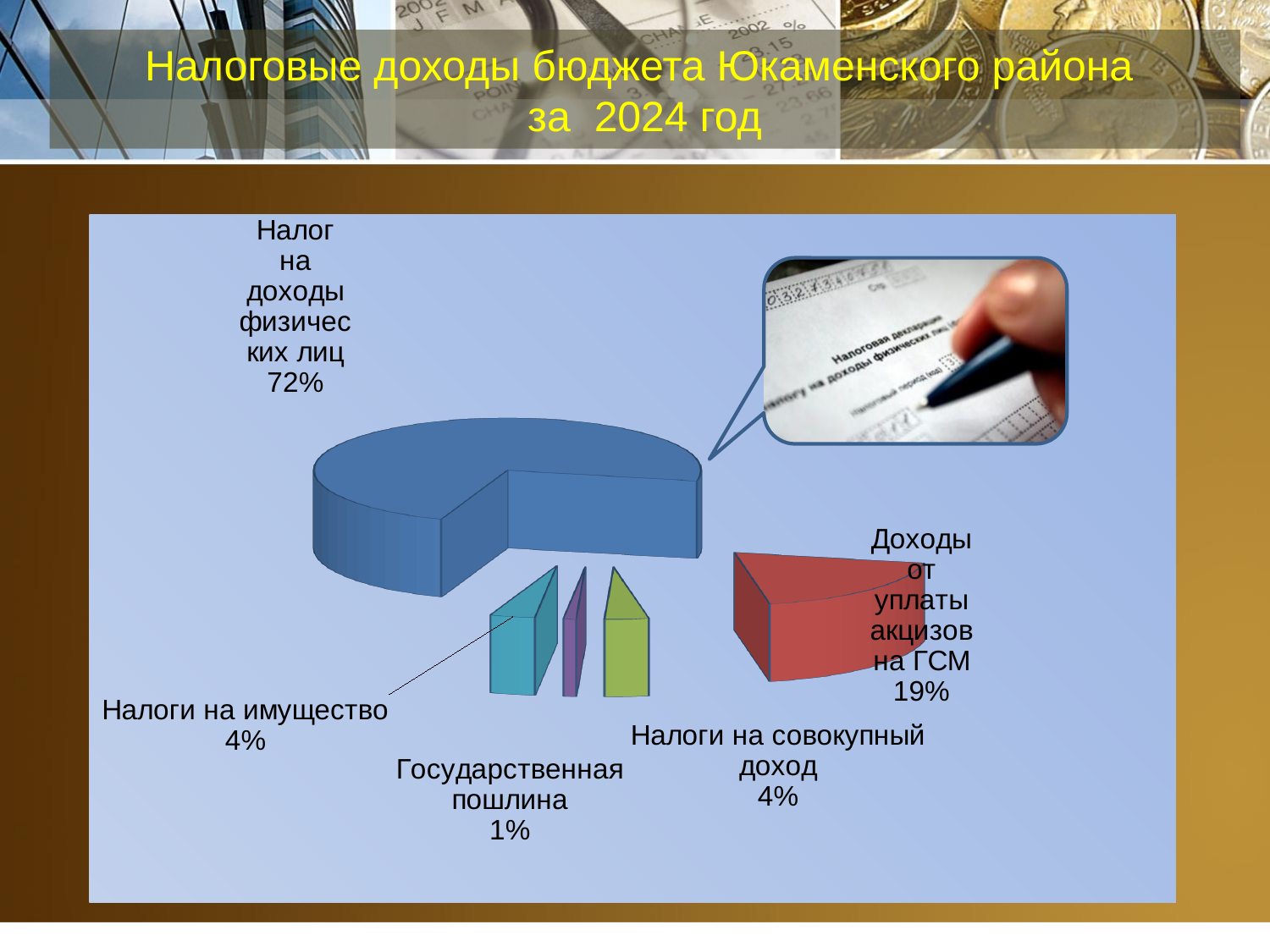
Which category has the largest share of the pie? Налог на доходы физических лиц What share of the pie does 'Доходы от уплаты акцизов на ГСМ' account for? 19% How many categories (slices) does the pie chart show? 5 What kind of chart is shown on the slide? Pie chart What is the value shown for 'Налоги на имущество'? 4% Which category has the smallest share of the pie? Государственная пошлина What is the title of the slide? Налоговые доходы бюджета Юкаменского района за 2024 год What share of the pie does 'Налог на доходы физических лиц' account for? 72% What is the value shown for 'Государственная пошлина'? 1% What is the value shown for 'Налоги на совокупный доход'? 4% By how many percentage points does 'Налог на доходы физических лиц' exceed 'Доходы от уплаты акцизов на ГСМ'? 53 percentage points Which is larger: the share for 'Доходы от уплаты акцизов на ГСМ' or the share for 'Налоги на имущество'? Доходы от уплаты акцизов на ГСМ